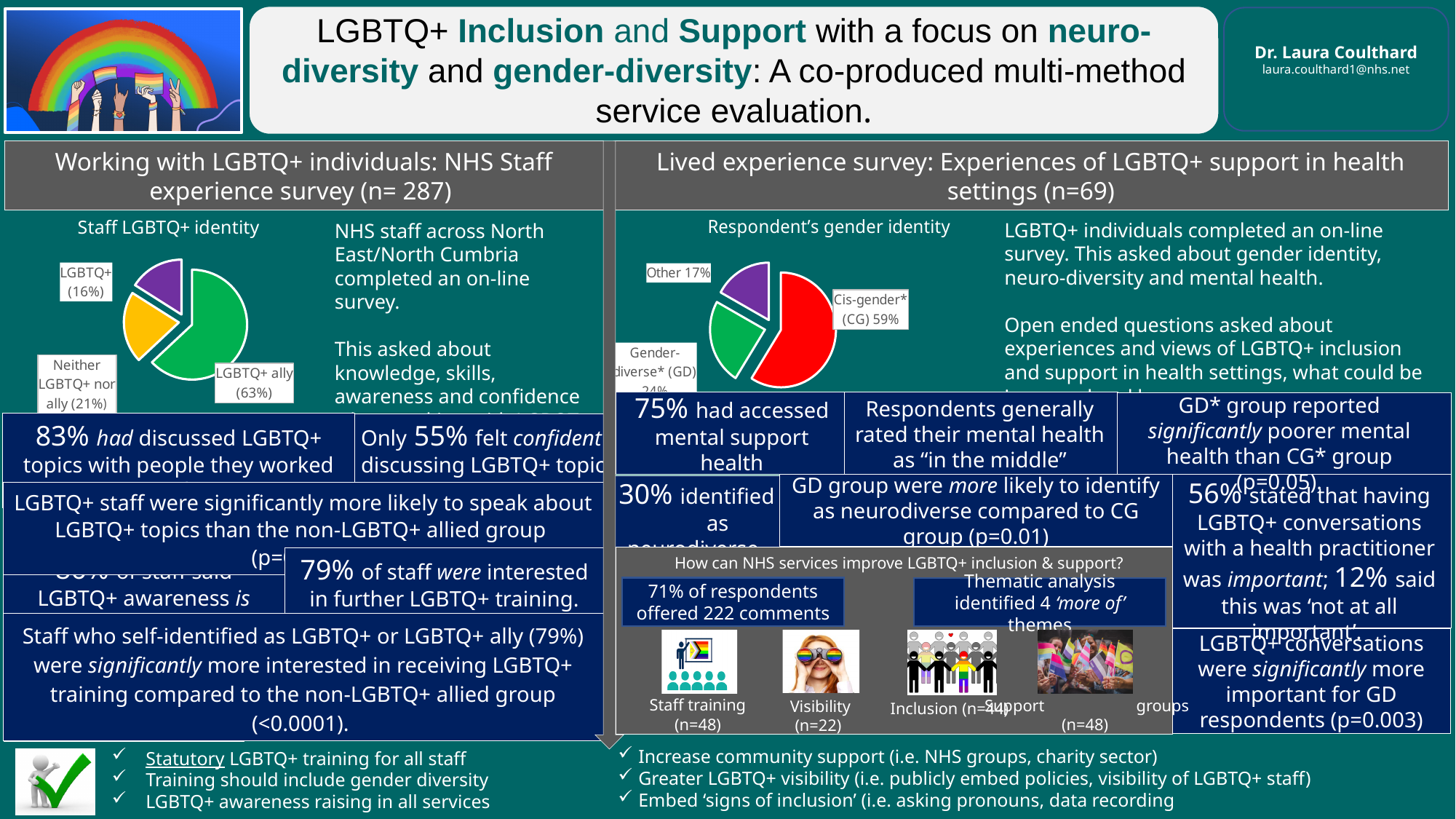
In the 'Respondent's gender identity' chart, what share of respondents were in the 'Other' category? 17% In the 'Staff LGBTQ+ identity' chart, what is the difference in percentage points between the LGBTQ+ ally slice and the LGBTQ+ slice? 47 What kind of chart is the 'Staff LGBTQ+ identity' chart? Pie chart In the 'Respondent's gender identity' chart, which category has the largest slice? Cis-gender* (CG) In the 'Staff LGBTQ+ identity' chart, what share of staff identified as LGBTQ+? 16% In the 'Staff LGBTQ+ identity' chart, which category has the smallest slice? LGBTQ+ In the 'Staff LGBTQ+ identity' chart, what share of staff were neither LGBTQ+ nor ally? 21% In the 'Staff LGBTQ+ identity' chart, what share of staff identified as LGBTQ+ ally? 63% How many slices does the 'Staff LGBTQ+ identity' pie chart have? 3 In the 'Staff LGBTQ+ identity' chart, which category has the largest slice? LGBTQ+ ally In the 'Respondent's gender identity' chart, which slice is larger: Cis-gender (CG) or Other? Cis-gender (CG) In the 'Respondent's gender identity' chart, what share of respondents were Cis-gender (CG)? 59%